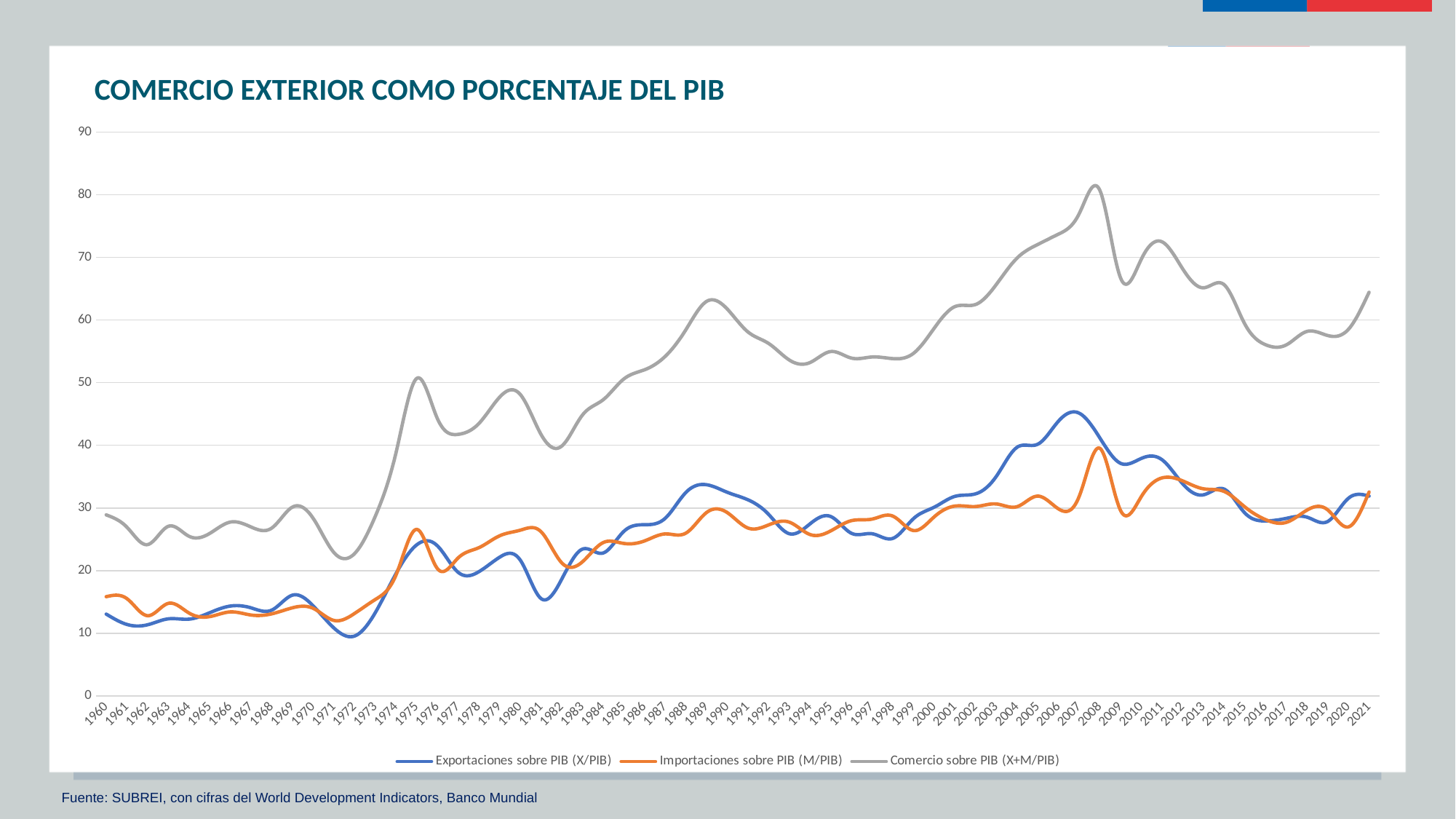
How many years are shown along the x axis? 62 Is the value for Exportaciones sobre PIB (X/PIB) in 1972 greater or less than 20? less What kind of chart is shown on the slide? line chart In which year does Exportaciones sobre PIB (X/PIB) reach its lowest value? 1972 What is the title of the chart? COMERCIO EXTERIOR COMO PORCENTAJE DEL PIB Which series is drawn in grey? Comercio sobre PIB (X+M/PIB) Does Comercio sobre PIB (X+M/PIB) rise or fall between 2008 and 2016? fall In 2007, which is larger: Exportaciones sobre PIB (X/PIB) or Importaciones sobre PIB (M/PIB)? Exportaciones sobre PIB (X/PIB) In which year does Exportaciones sobre PIB (X/PIB) reach its highest value? 2007 Is the value for Comercio sobre PIB (X+M/PIB) in 2008 greater or less than 70? greater How many series does the legend list? 3 In which year does Comercio sobre PIB (X+M/PIB) reach its highest value? 2008